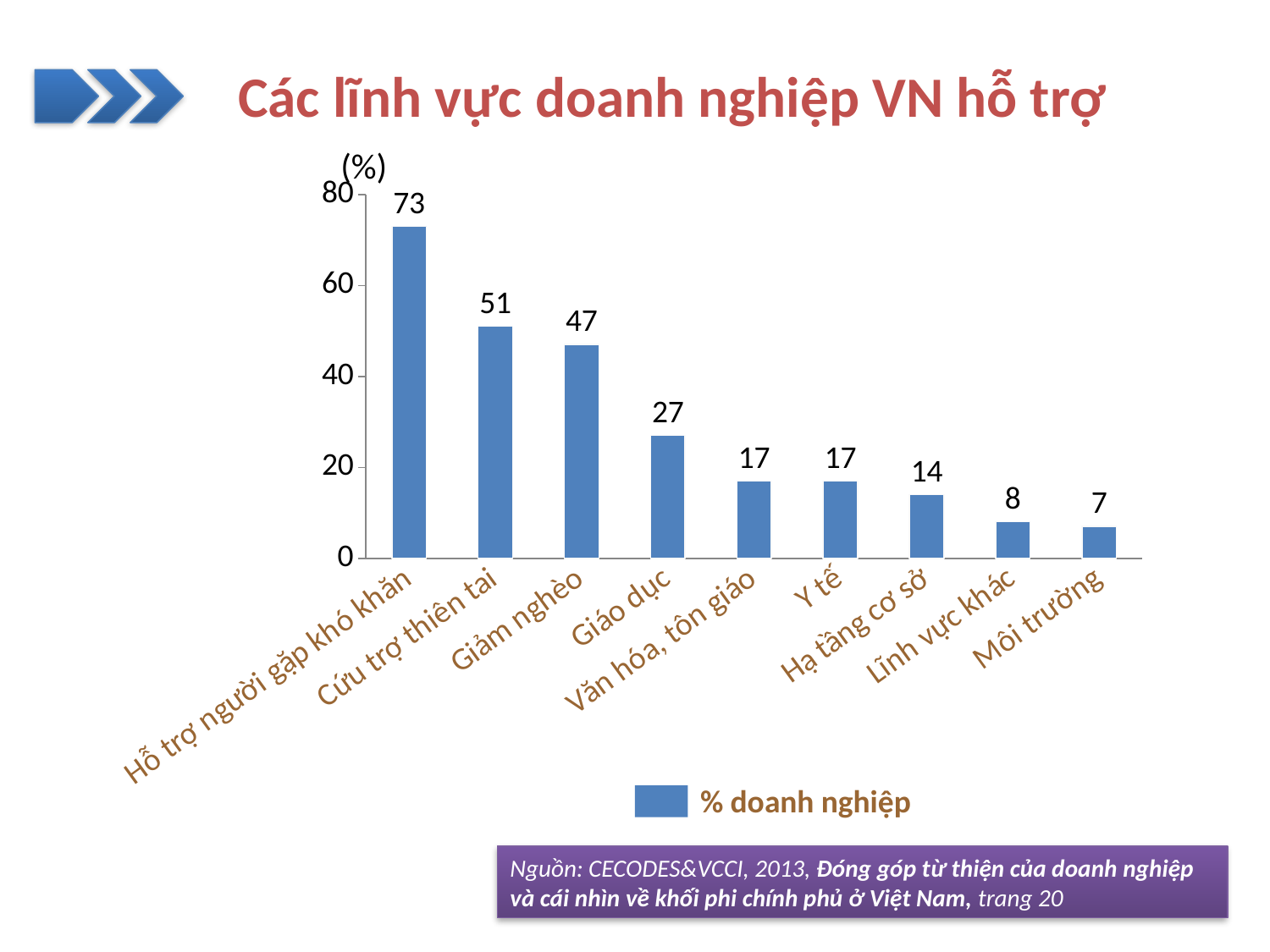
Which category has the highest value? Hỗ trợ người gặp khó khăn What is the legend entry for the series? % doanh nghiệp Is the value for Cứu trợ thiên tai greater or less than 40? greater Which is larger, the value for Lĩnh vực khác or the value for Môi trường? Lĩnh vực khác How many categories are shown on the x axis? 9 What is the value for Giảm nghèo? 47 How many series does the legend list? 1 What kind of chart is shown on the slide? bar chart What is the value for Giáo dục? 27 Which category has the lowest value? Môi trường What is the difference between the values for Hỗ trợ người gặp khó khăn and Cứu trợ thiên tai? 22 What is the value for Hạ tầng cơ sở? 14